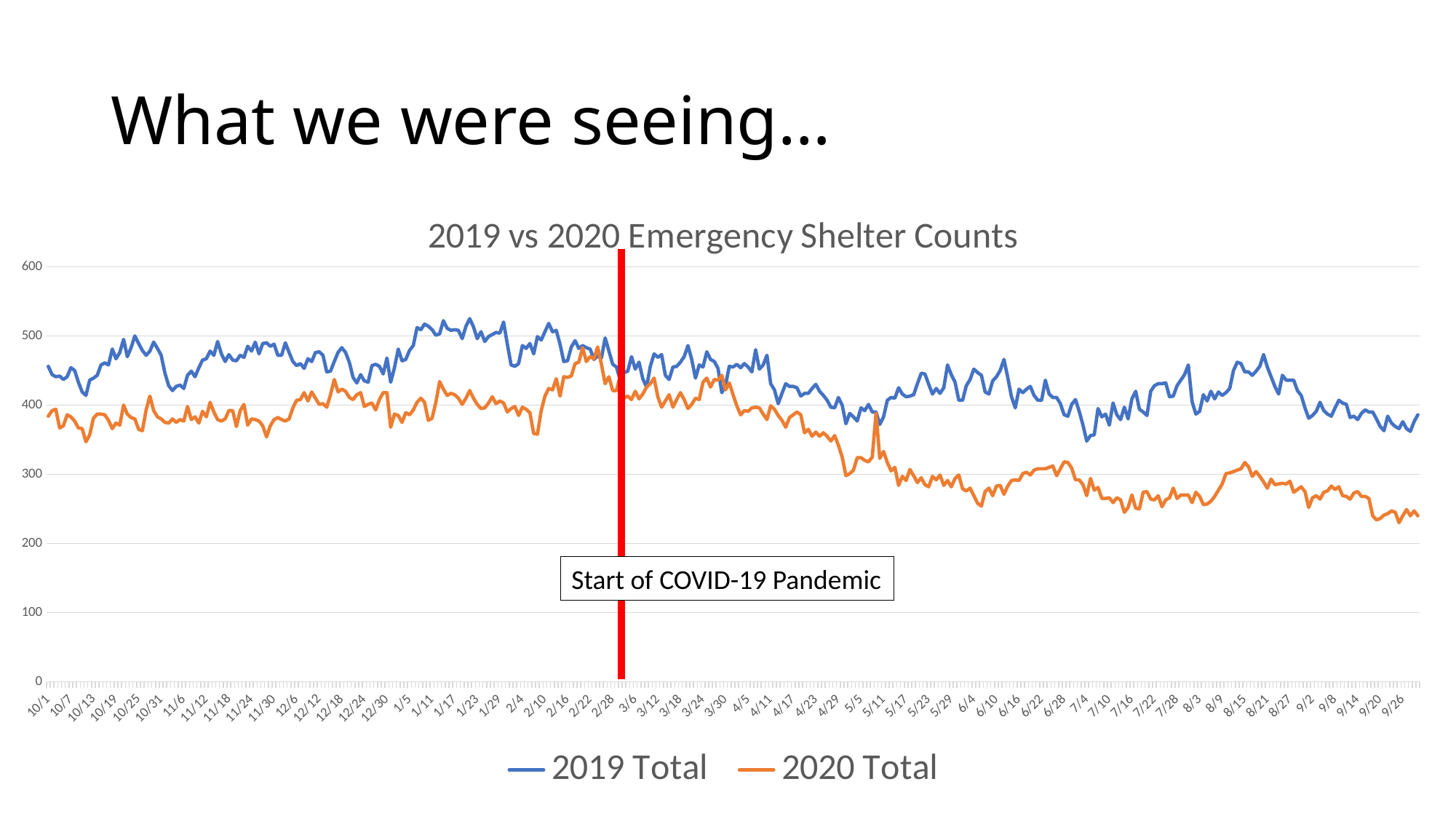
Is the value for 2020 Total on 10/1 greater or less than 400? less Does the 2020 Total series generally rise or fall between 3/30 and 9/26? Fall On 9/26, which series has the larger value, 2019 Total or 2020 Total? 2019 Total What kind of chart is shown on the slide? Line chart On 6/4, which series has the larger value, 2019 Total or 2020 Total? 2019 Total Is the value for 2020 Total on 9/26 greater or less than 300? less How many series does the legend list? 2 What is the title of the chart? 2019 vs 2020 Emergency Shelter Counts What does the label next to the red vertical line on the chart say? Start of COVID-19 Pandemic Is the value for 2020 Total on 6/4 greater or less than 300? less